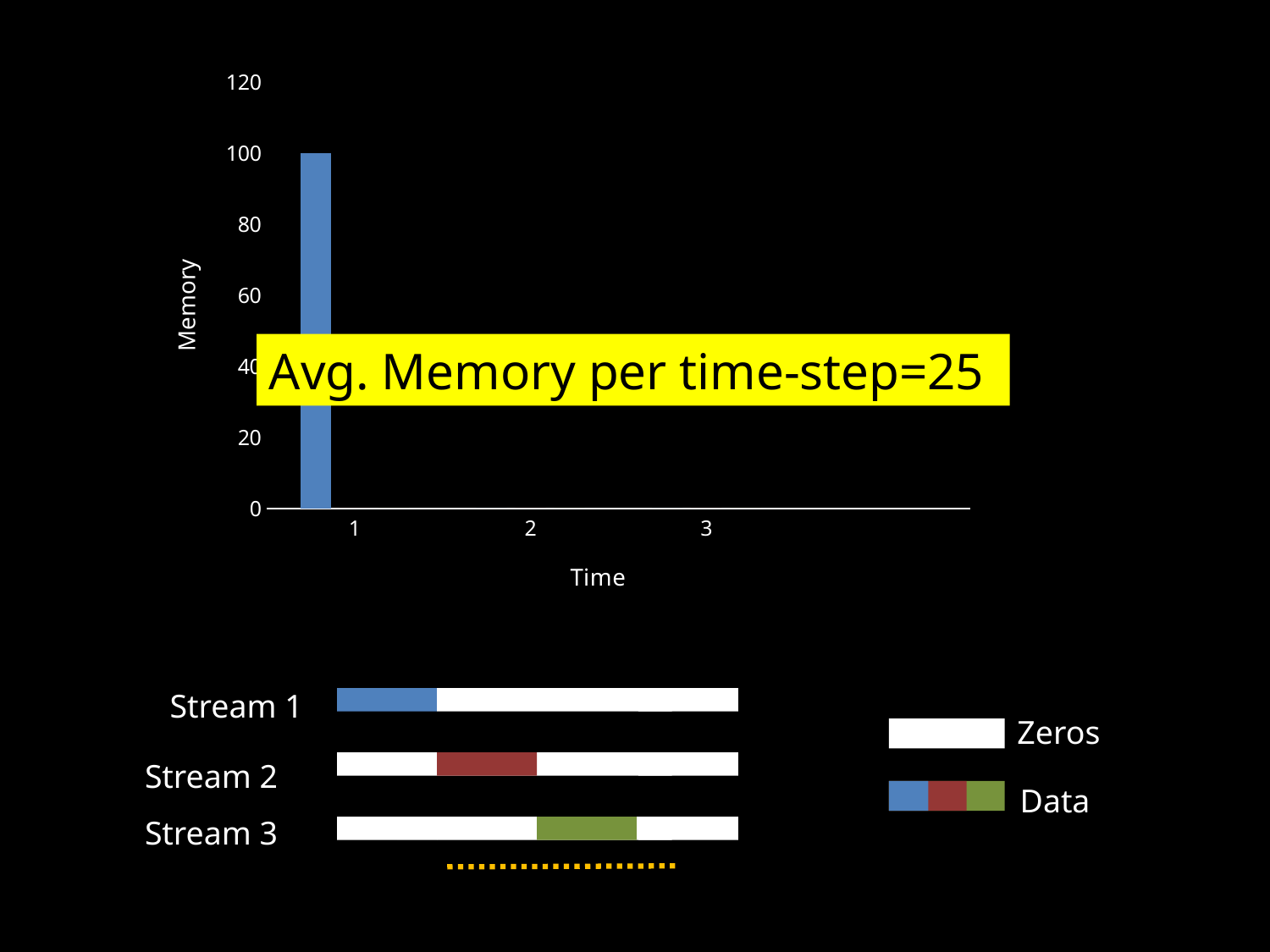
How many labelled Time categories are shown on the x axis? 3 What is the highest tick value shown on the Memory axis? 120 Is the value of the bar at Time 1 greater or less than 80? greater What is the Memory value of the bar at Time 1? 100 What kind of chart is shown at the top of the slide? bar chart According to the highlighted text on the chart, what is the average memory per time-step? 25 Which Time category has the highest Memory value? 1 What is the label of the horizontal axis? Time What is the label of the vertical axis? Memory Is the value of the bar at Time 1 greater or less than 120? less